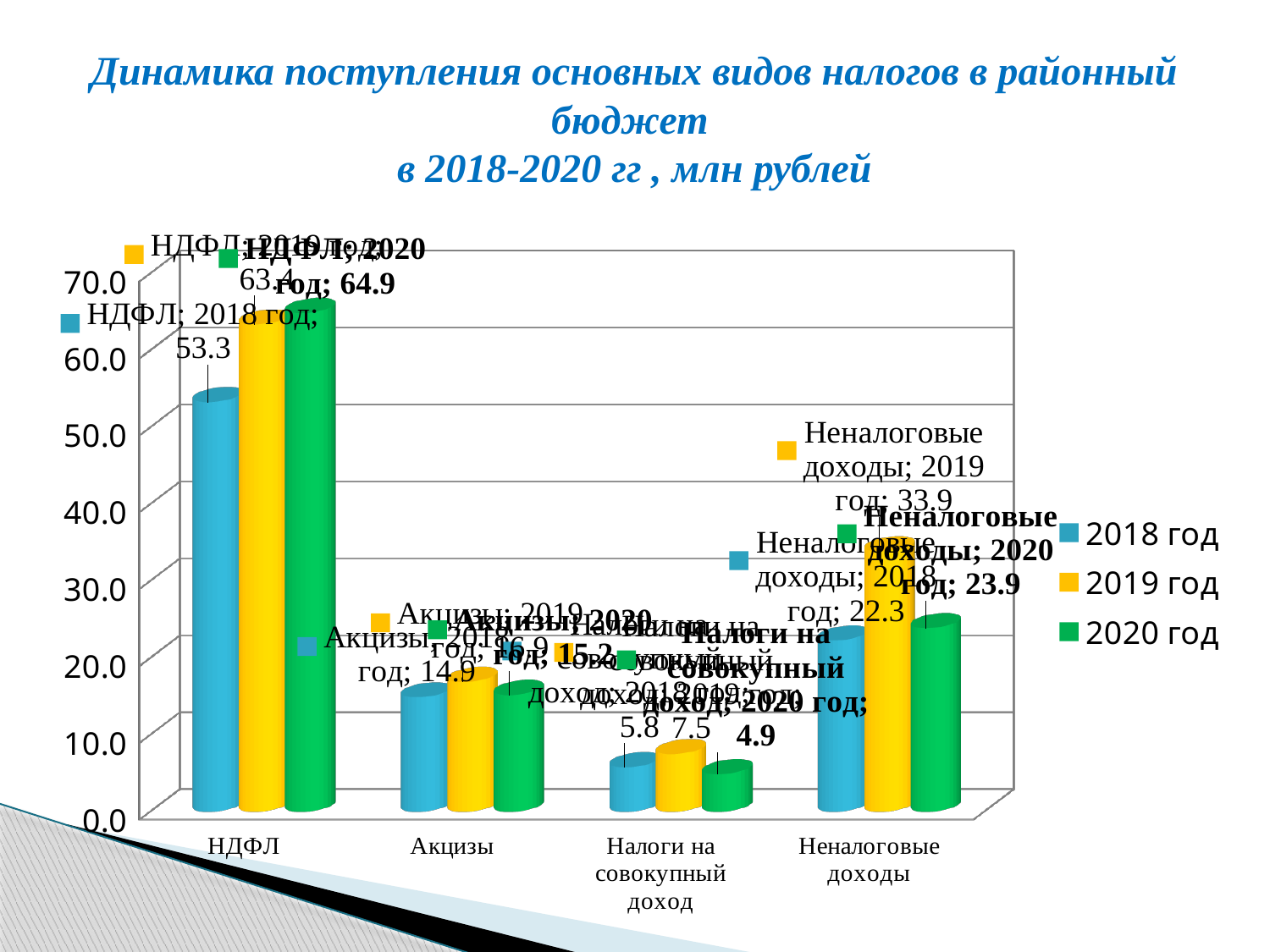
What kind of chart is shown on the slide? bar chart How many categories are shown on the x axis? 4 What is the value for Неналоговые доходы in 2019 год? 33.9 Which category has the lowest value for 2019 год? Налоги на совокупный доход For Неналоговые доходы, which year has the larger value, 2019 год or 2020 год? 2019 год What is the value for НДФЛ in 2020 год? 64.9 What is the difference between the НДФЛ values for 2020 год and 2018 год? 11.6 How many series does the legend list? 3 Which category has the highest value for 2018 год? НДФЛ What is the value for Налоги на совокупный доход in 2020 год? 4.9 Is the value for Акцизы in 2019 год greater or less than 20.0? less What is the value for НДФЛ in 2018 год? 53.3